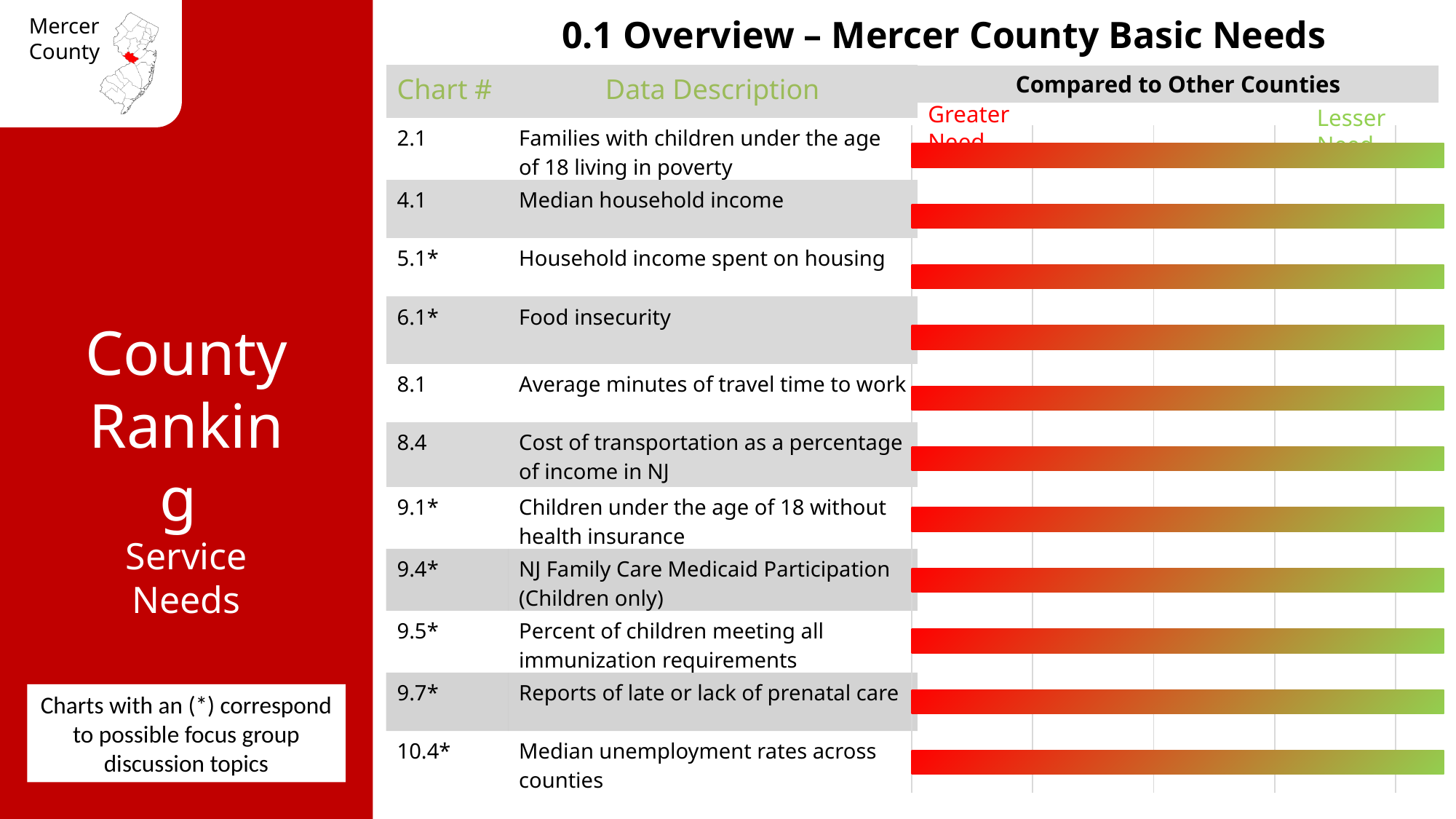
What label appears at the left (red) end of the bars in the chart? Greater Need Which data description corresponds to chart number 8.1? Average minutes of travel time to work Which chart number corresponds to the bar labelled "Food insecurity"? 6.1* How many bars are plotted in the "Compared to Other Counties" chart? 11 What kind of chart is shown on the right side of the slide under "Compared to Other Counties"? bar chart Which data description corresponds to chart number 10.4*? Median unemployment rates across counties How many data descriptions are listed in the table alongside the chart? 11 What is the title of the slide containing the chart? 0.1 Overview – Mercer County Basic Needs